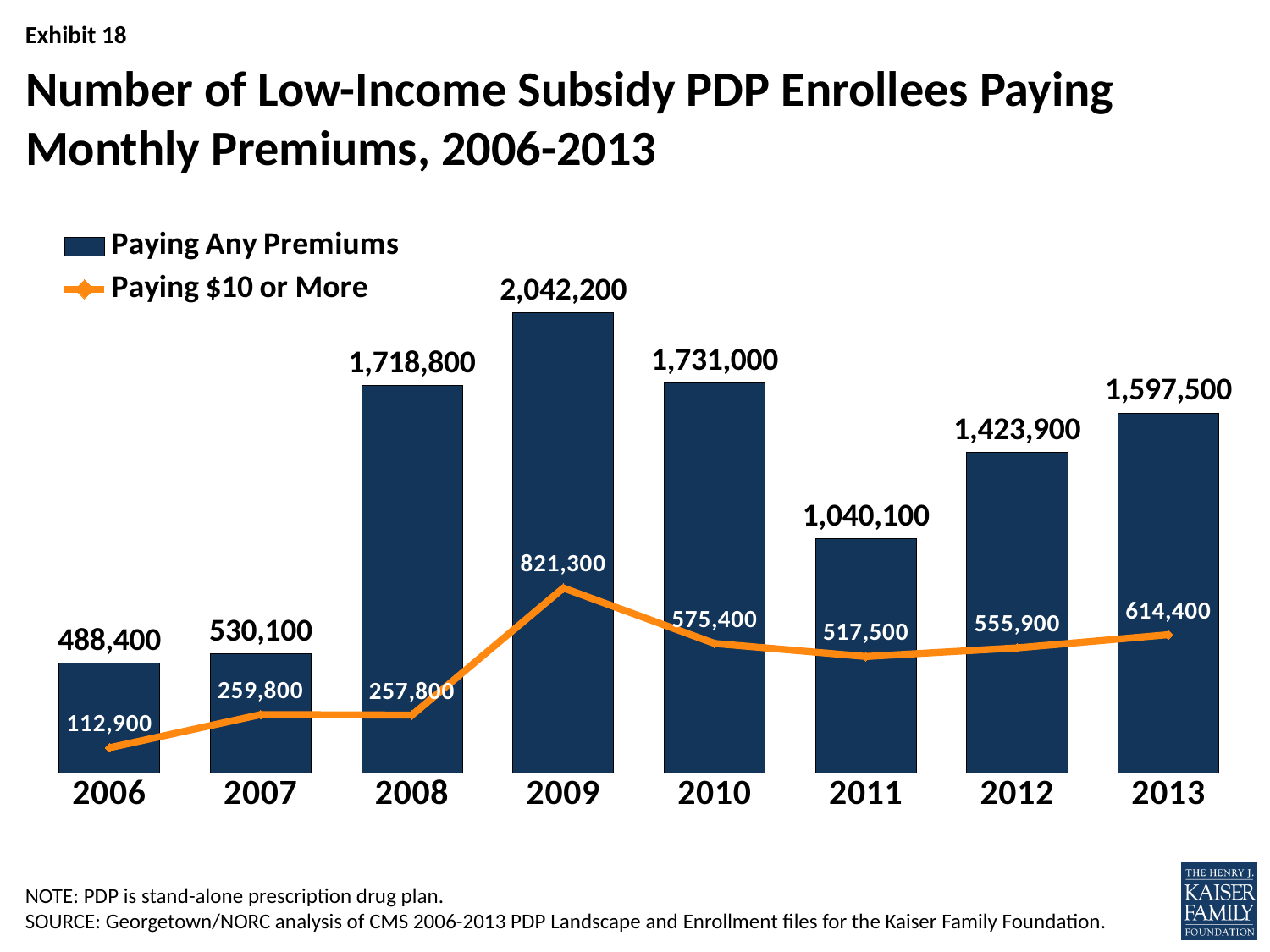
Which year has the lowest value for Paying $10 or More? 2006 What kind of chart is this? Combined bar and line chart Does the Paying $10 or More series rise or fall from 2011 to 2013? Rise What is the value for Paying $10 or More in 2006? 112,900 What is the value for Paying Any Premiums in 2009? 2,042,200 Which is larger, the Paying Any Premiums value in 2010 or in 2008? 2010 How many series does the legend list? 2 Which year has the highest value for Paying Any Premiums? 2009 What is the value for Paying $10 or More in 2012? 555,900 How many years are shown on the x axis? 8 What is the difference between Paying Any Premiums and Paying $10 or More in 2009? 1,220,900 How much higher is the Paying Any Premiums value in 2013 than in 2012? 173,600